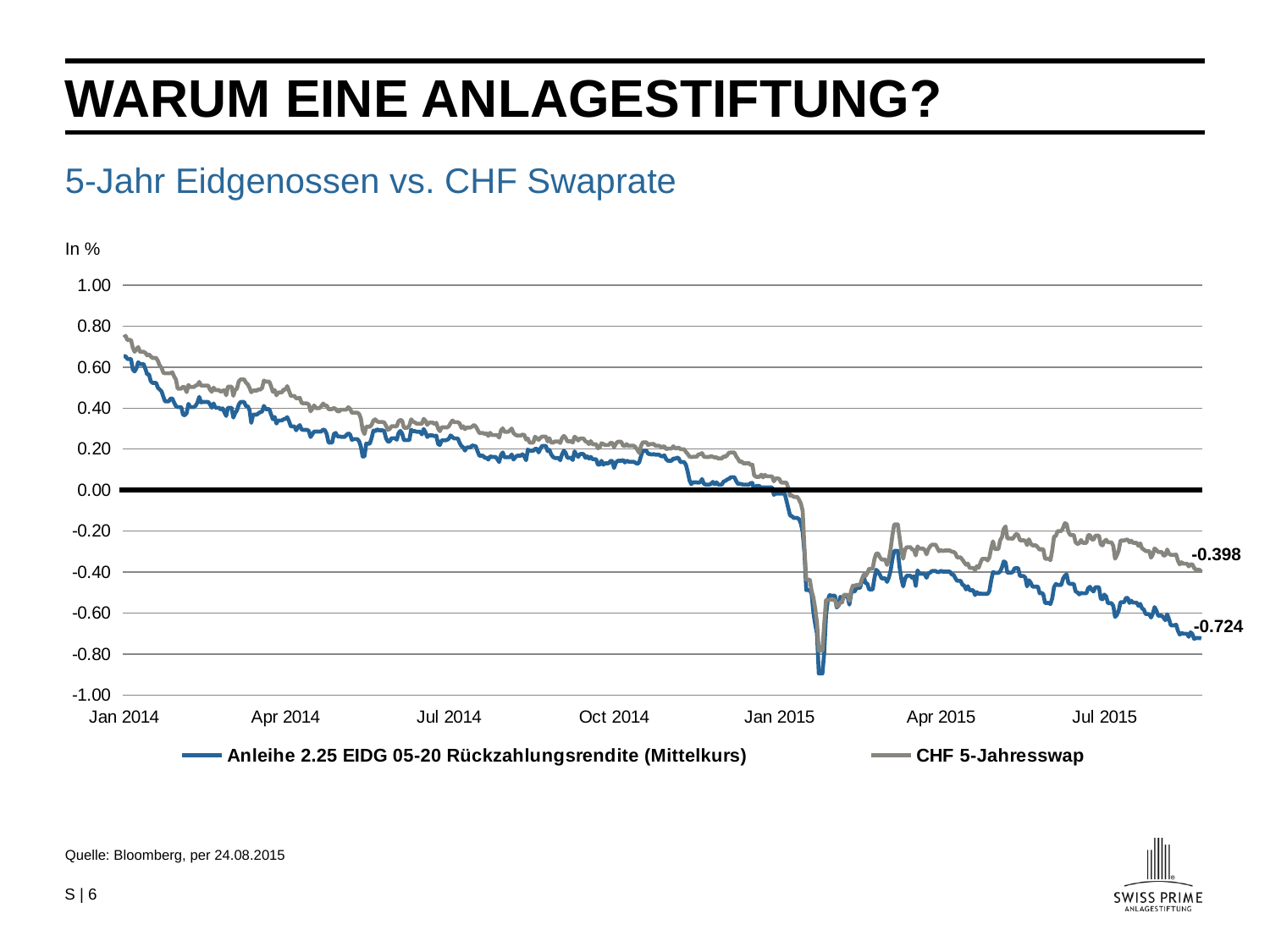
What is the title of the chart? 5-Jahr Eidgenossen vs. CHF Swaprate Is the value of the CHF 5-Jahresswap series at Jan 2014 greater or less than 0.60? greater What is the last labelled value of the CHF 5-Jahresswap series? -0.398 Is the value of the Anleihe 2.25 EIDG 05-20 series at Jan 2014 greater or less than 0.40? greater What is the difference between the final labelled values of the CHF 5-Jahresswap (-0.398) and the Anleihe 2.25 EIDG 05-20 (-0.724)? 0.326 What is the last labelled value of the Anleihe 2.25 EIDG 05-20 Rückzahlungsrendite (Mittelkurs) series? -0.724 Do the values of the Anleihe 2.25 EIDG 05-20 series generally rise or fall from Jan 2014 to the end of the chart? Fall Is the value of the CHF 5-Jahresswap series at Jul 2015 greater or less than 0.00? less What unit is indicated for the y axis of the chart? In % At the end of the chart, which series has the higher value: the CHF 5-Jahresswap or the Anleihe 2.25 EIDG 05-20? CHF 5-Jahresswap How many series does the legend list? 2 What kind of chart is shown on the slide? Line chart